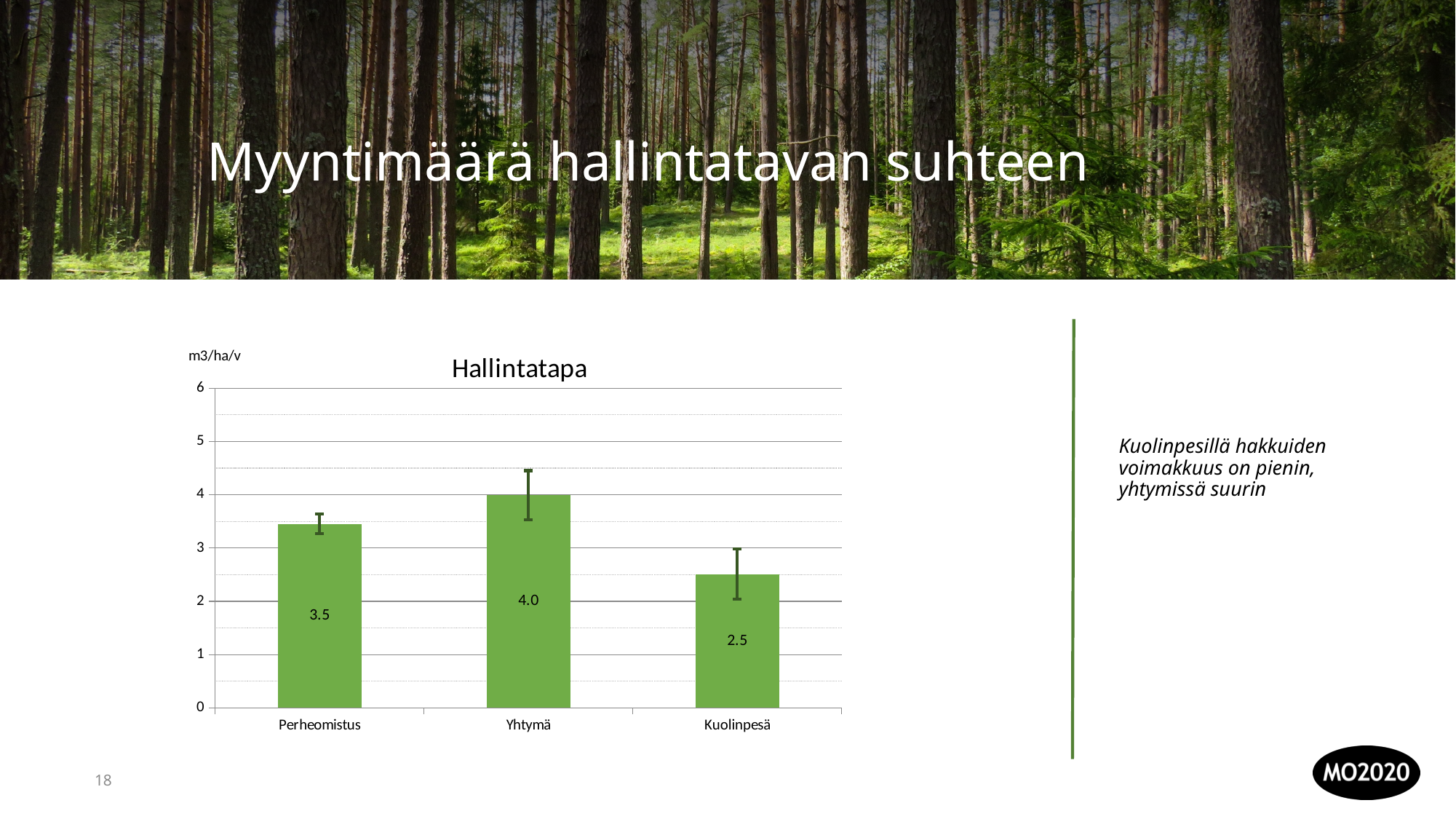
What is the title of the chart? Hallintatapa Which is larger, the value for Perheomistus or the value for Yhtymä? Yhtymä What is the difference between the values for Yhtymä and Kuolinpesä? 1.5 What is the difference between the values for Perheomistus and Kuolinpesä? 1.0 Is the value for Kuolinpesä greater or less than 3? less What is the value for Kuolinpesä? 2.5 How many categories are shown on the x axis? 3 What is the value for Perheomistus? 3.5 Which category has the highest value? Yhtymä What is the value for Yhtymä? 4.0 What kind of chart is shown on the slide? bar chart Which category has the lowest value? Kuolinpesä